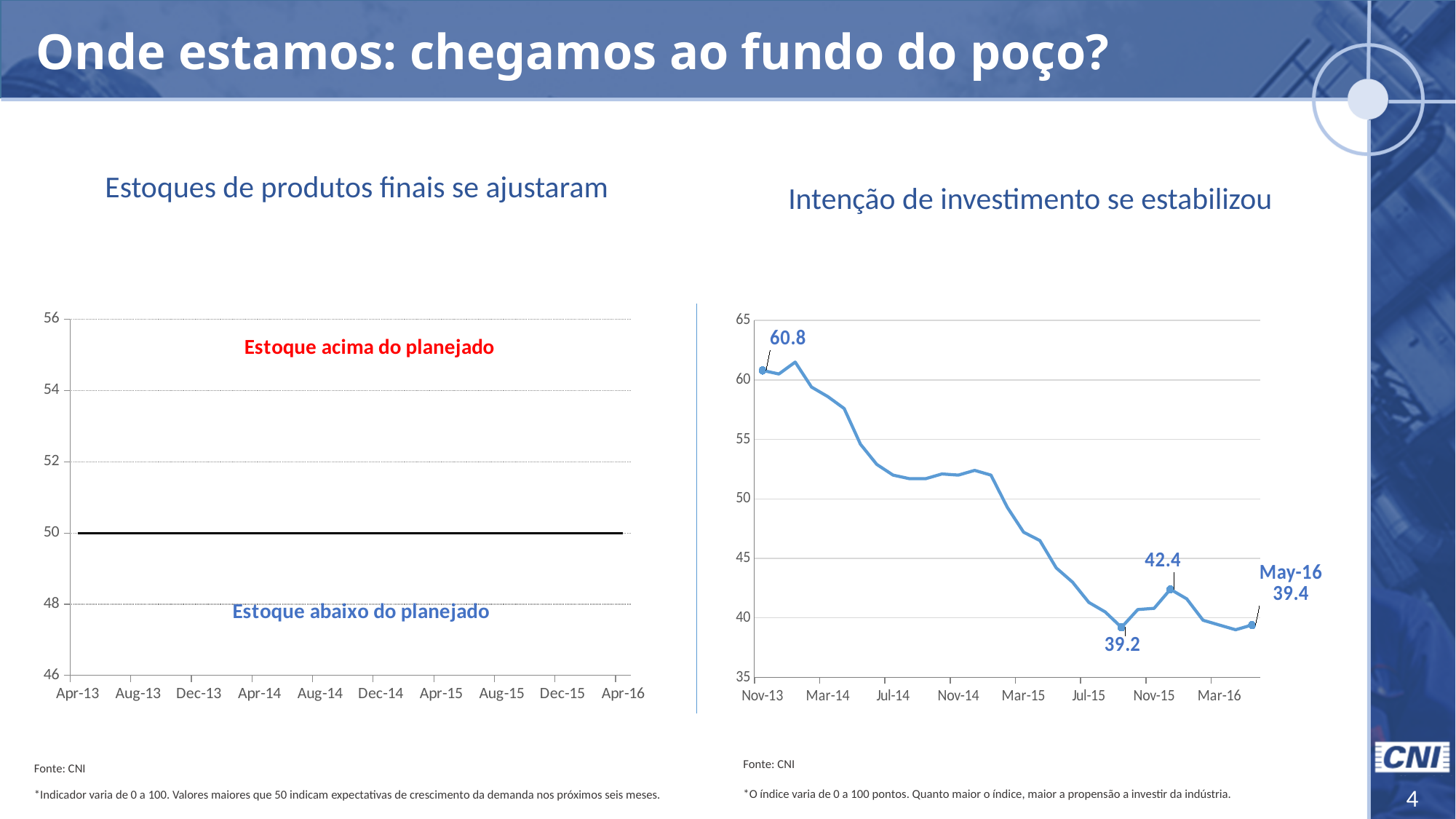
On the right chart (Intenção de investimento se estabilizou), what is the lowest labelled value on the line? 39.2 On the right chart (Intenção de investimento se estabilizou), does the line overall rise or fall from Nov-13 to May-16? fall On the right chart (Intenção de investimento se estabilizou), what is the highest labelled value on the line? 60.8 On the right chart (Intenção de investimento se estabilizou), what is the value labelled at Nov-13? 60.8 On the right chart (Intenção de investimento se estabilizou), is the value at Jul-14 greater or less than 50? greater On the right chart (Intenção de investimento se estabilizou), what is the difference between the Nov-13 value (60.8) and the May-16 value (39.4)? 21.4 On the right chart (Intenção de investimento se estabilizou), what is the difference between the labelled peak of 42.4 and the labelled low of 39.2? 3.2 On the right chart (Intenção de investimento se estabilizou), what is the value labelled for May-16? 39.4 On the right chart (Intenção de investimento se estabilizou), is the value at Mar-15 greater or less than 50? less On the right chart (Intenção de investimento se estabilizou), which is larger: the labelled value 42.4 near Nov-15 or the May-16 value? 42.4 What kind of chart is the right chart (Intenção de investimento se estabilizou)? line chart On the left chart (Estoques de produtos finais se ajustaram), at what value on the y axis is the horizontal black line drawn? 50